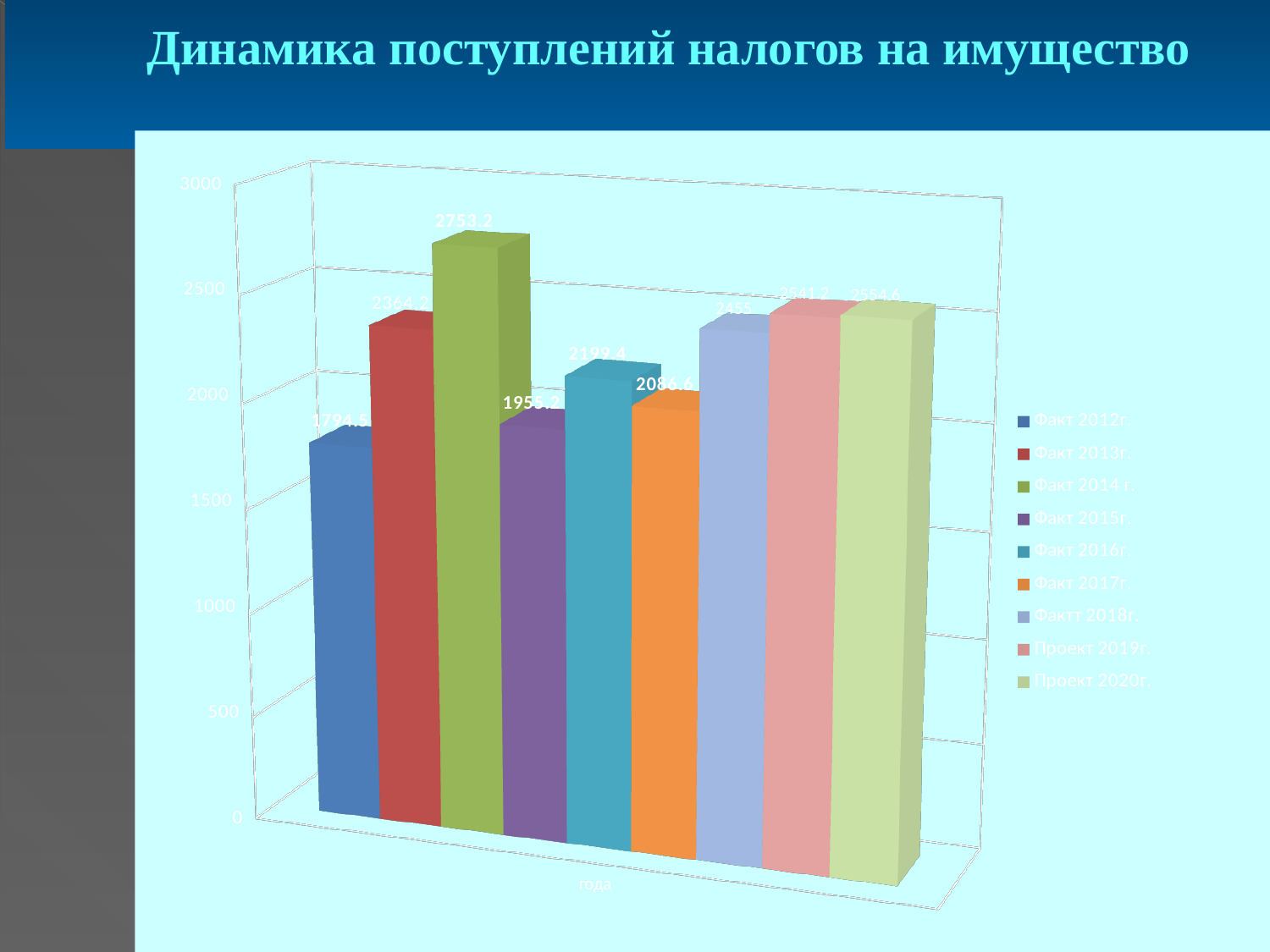
How many series does the legend list? 9 Is the value for Факт 2012г. greater or less than 2000? less What is the difference between the values for Факт 2014 г. and Факт 2013г.? 389 What is the value for Проект 2020г.? 2554.6 Which series has the highest value? Факт 2014 г. What is the difference between the values for Проект 2020г. and Проект 2019г.? 13.4 Which is larger, the value for Факт 2013г. or the value for Факт 2016г.? Факт 2013г. What is the value for Факт 2012г.? 1794.5 What is the value for Факт 2018г.? 2455 Which series has the lowest value? Факт 2012г. What kind of chart is shown on the slide? bar chart What is the value for Факт 2014 г.? 2753.2